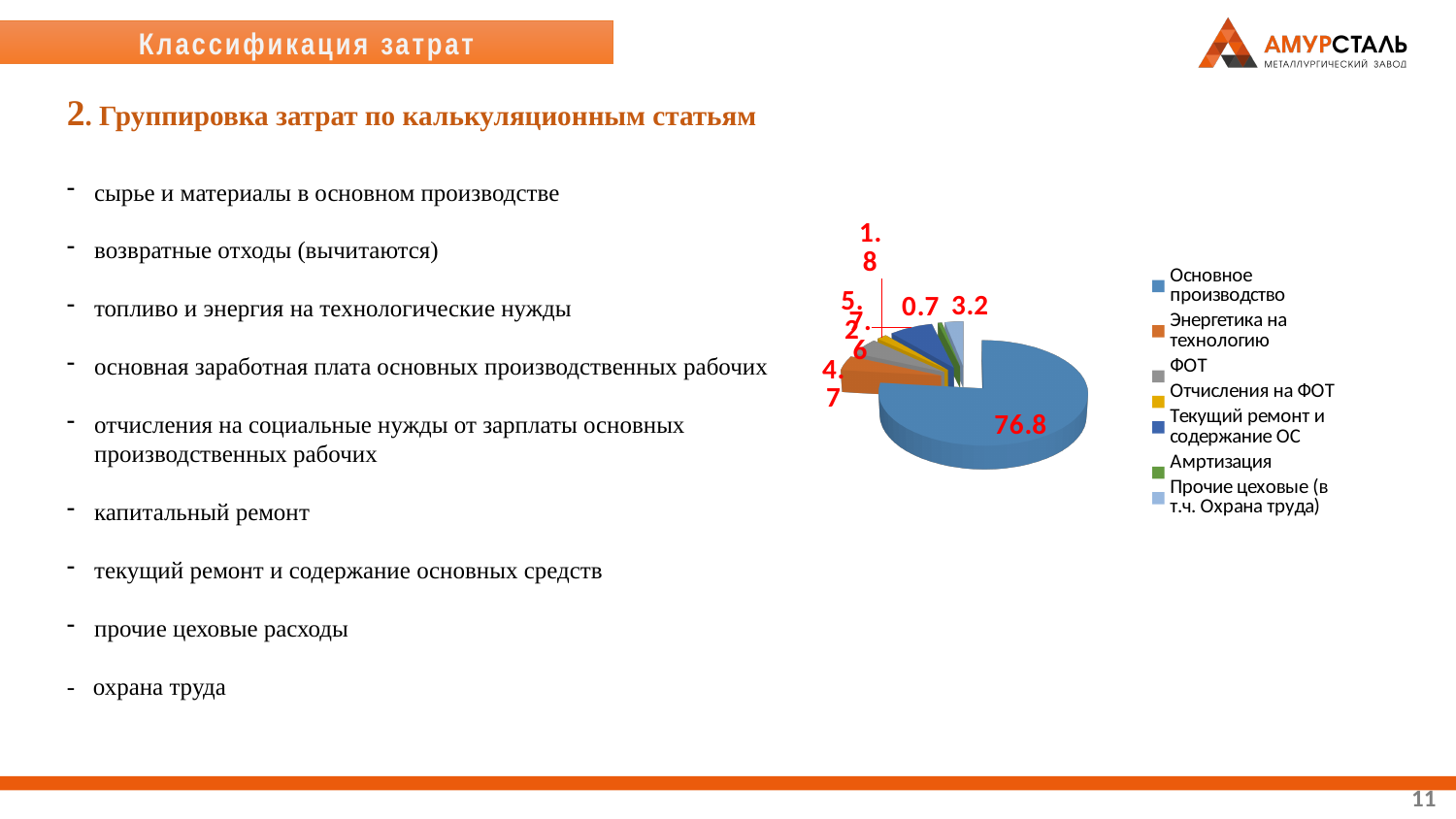
What is the difference between the values for Основное производство and Прочие цеховые (в т.ч. Охрана труда)? 73.6 Which legend entry is listed second? Энергетика на технологию What value is shown for Прочие цеховые (в т.ч. Охрана труда)? 3.2 What value is shown for Основное производство? 76.8 Which category has the largest slice of the pie? Основное производство What colour is the slice for Основное производство? blue Which category has the smallest slice of the pie? Амртизация What kind of chart is shown on the slide? pie chart Is the value for Основное производство greater or less than 50? greater Which is larger, the slice for Основное производство or the slice for Прочие цеховые (в т.ч. Охрана труда)? Основное производство What value is shown for Амртизация? 0.7 How many categories does the legend list? 7